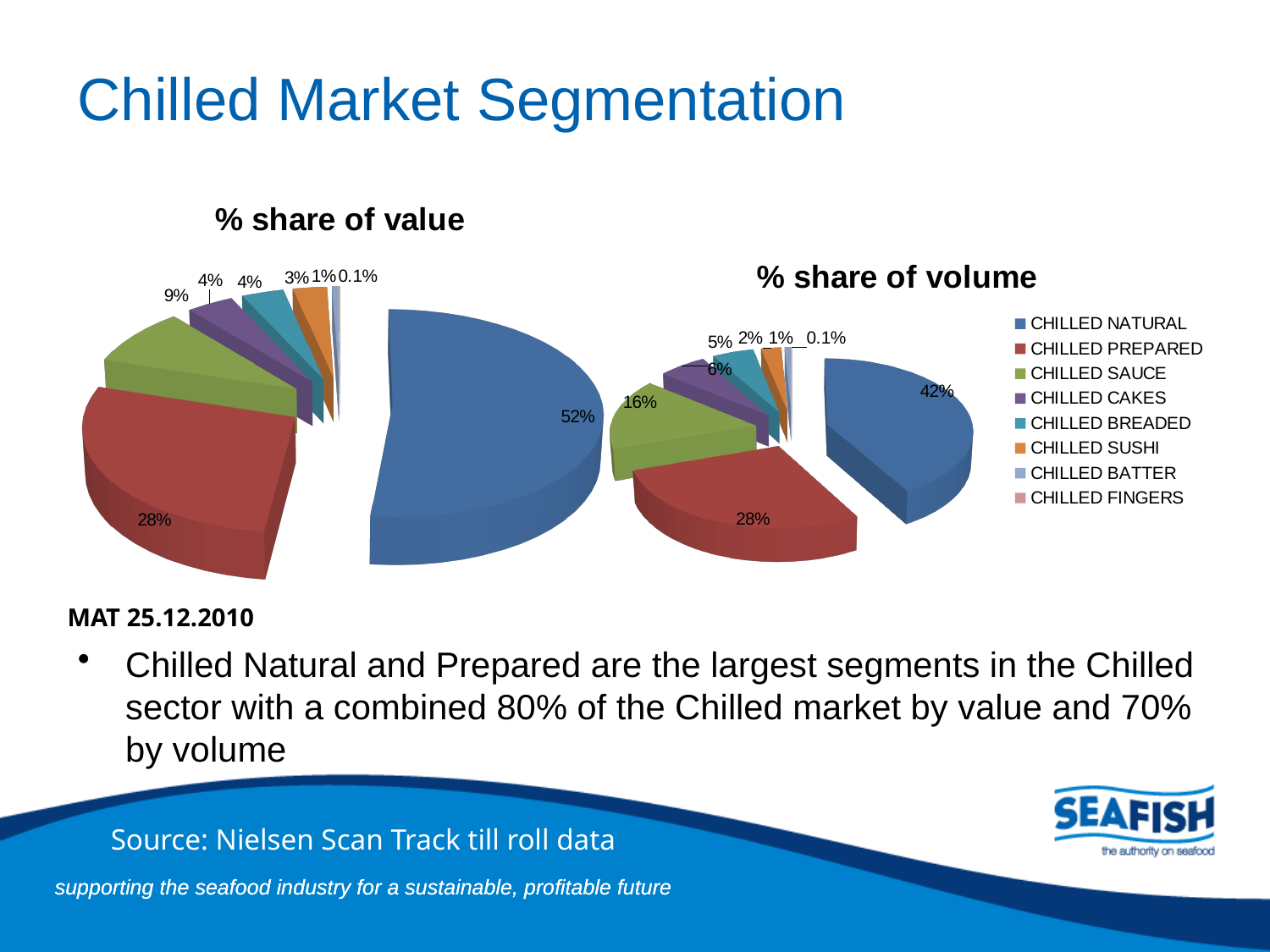
In the '% share of value' chart, what share does CHILLED PREPARED have? 28% How many entries does the legend list? 8 In the '% share of value' chart, what is the difference between the CHILLED NATURAL share and the CHILLED PREPARED share? 24% In the '% share of volume' chart, what share does CHILLED SAUCE have? 16% In the '% share of value' chart, what share does CHILLED SAUCE have? 9% What type of chart is the '% share of volume' chart? Pie chart In the '% share of volume' chart, what share does CHILLED NATURAL have? 42% What colour represents CHILLED PREPARED in the legend? Red In the '% share of volume' chart, which segment has the largest share? CHILLED NATURAL Is the CHILLED SAUCE share larger in the '% share of value' chart or the '% share of volume' chart? % share of volume In the '% share of value' chart, what share does CHILLED NATURAL have? 52% In the '% share of value' chart, which segment has the smallest share? CHILLED FINGERS